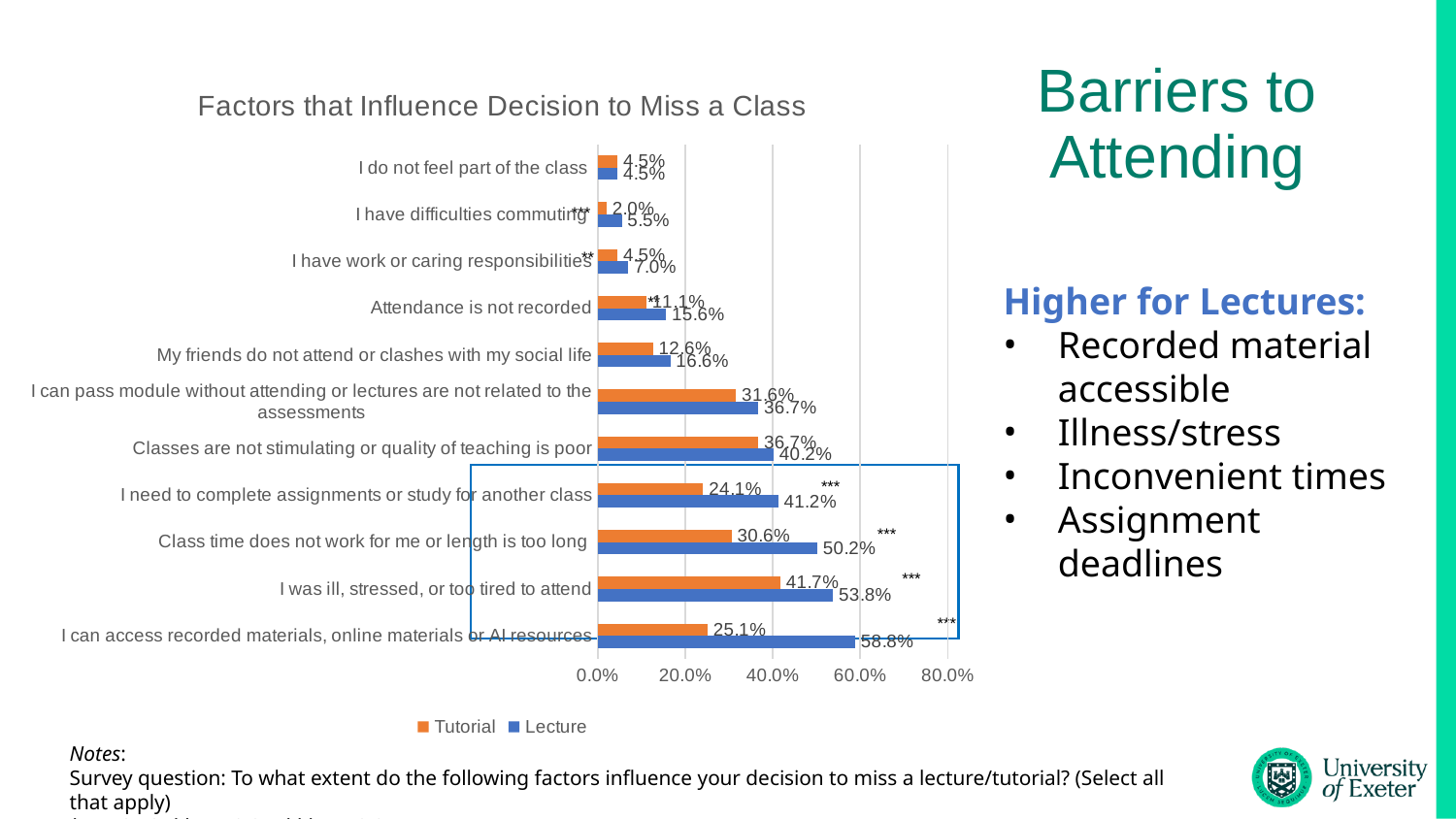
How many categories are shown on the chart? 11 Which is larger for "Attendance is not recorded": the Tutorial value or the Lecture value? Lecture How many series does the legend list? 2 What is the difference between the Lecture and Tutorial values for "I can access recorded materials, online materials or AI resources"? 33.7% What kind of chart is shown on the slide? Bar chart What is the title of the chart? Factors that Influence Decision to Miss a Class What is the Tutorial value for "I was ill, stressed, or too tired to attend"? 41.7% Which category has the lowest Tutorial value? I have difficulties commuting Which category has the highest Lecture value? I can access recorded materials, online materials or AI resources What is the Lecture value for "I can access recorded materials, online materials or AI resources"? 58.8% What is the Lecture value for "Class time does not work for me or length is too long"? 50.2% What is the difference between the Lecture and Tutorial values for "I need to complete assignments or study for another class"? 17.1%